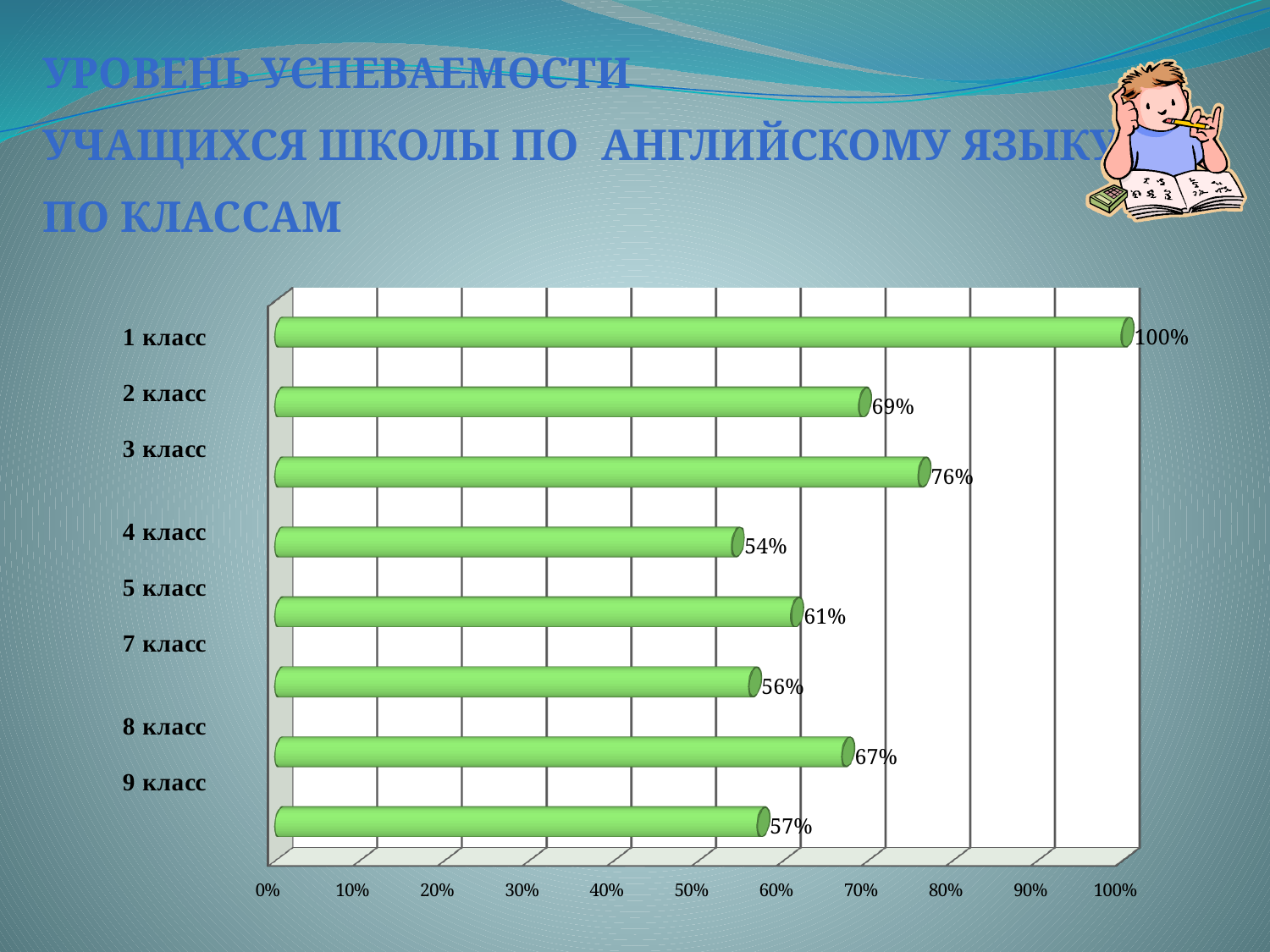
Which class has the lowest value? 4 класс Which is larger, the value for 5 класс or the value for 8 класс? 8 класс What is the value for 9 класс? 57% What is the value for 1 класс? 100% How many classes are shown on the chart? 8 What kind of chart is shown on the slide? bar chart What is the difference between the values for 2 класс and 4 класс? 15% What colour are the bars on the chart? green Is the value for 3 класс greater or less than 70%? greater Which class has the highest value? 1 класс What is the value for 7 класс? 56% What is the value for 3 класс? 76%